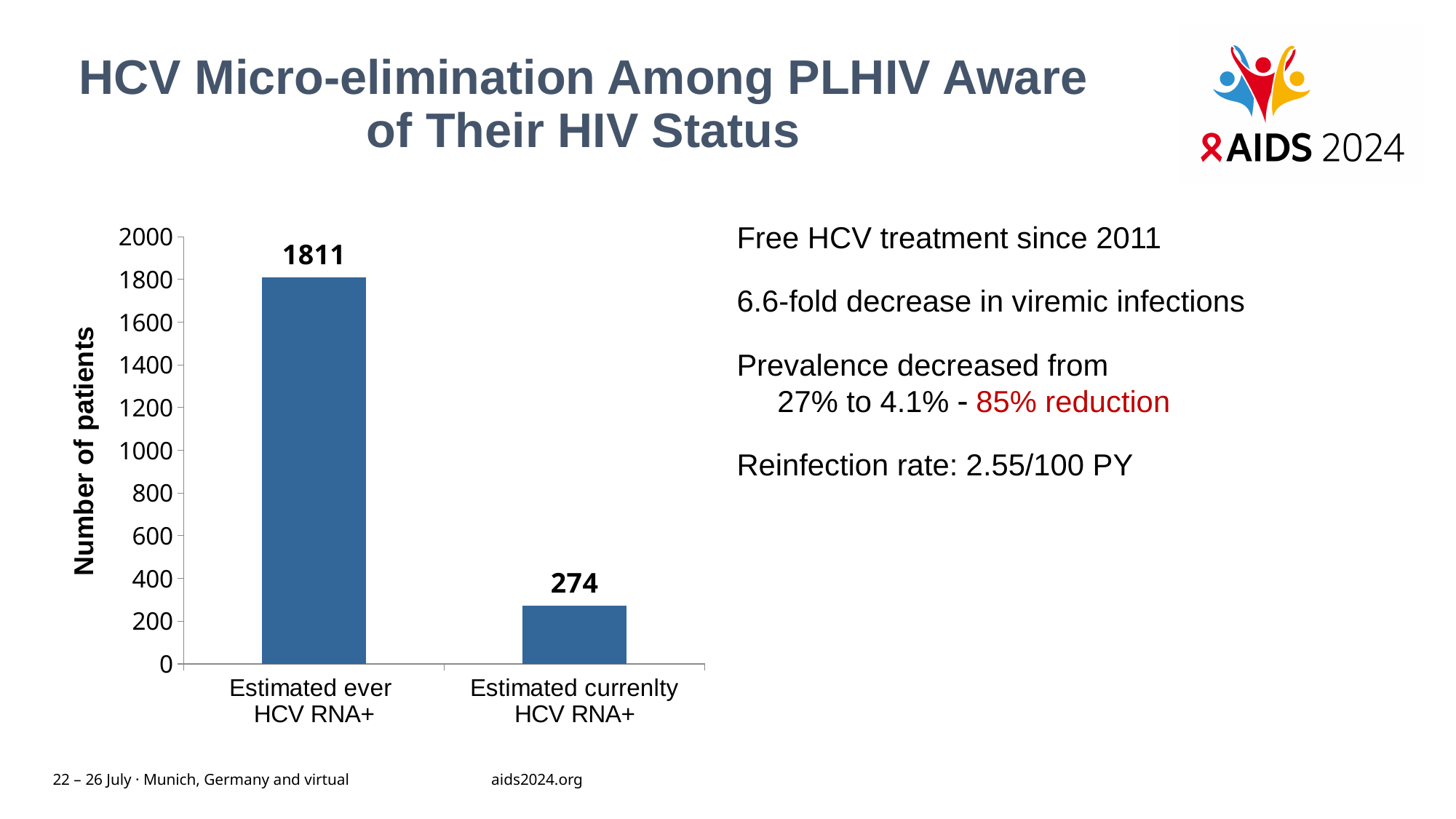
What is the maximum value shown on the vertical axis of the chart? 2000 What is the value for Estimated currenlty HCV RNA+? 274 What is the label of the vertical axis of the chart? Number of patients What kind of chart is shown on the slide? bar chart Is the value for Estimated currenlty HCV RNA+ greater or less than 400? less Which category has the lowest number of patients? Estimated currenlty HCV RNA+ What is the difference between the Estimated ever HCV RNA+ and Estimated currenlty HCV RNA+ values? 1537 Which is larger, the value for Estimated ever HCV RNA+ or Estimated currenlty HCV RNA+? Estimated ever HCV RNA+ Is the value for Estimated ever HCV RNA+ greater or less than 1600? greater How many categories are shown in the chart? 2 What is the value for Estimated ever HCV RNA+? 1811 Which category has the highest number of patients? Estimated ever HCV RNA+